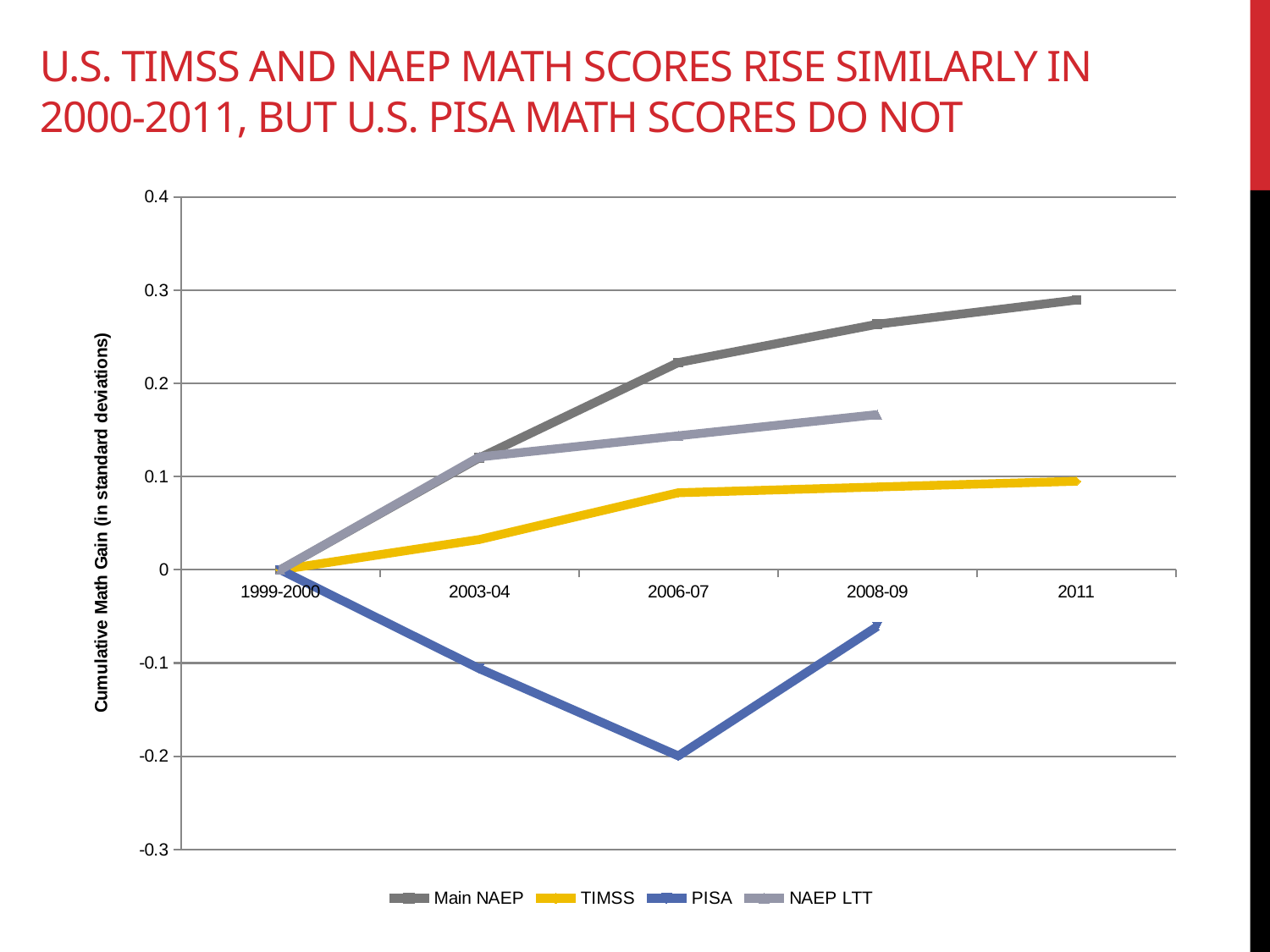
Which series has the highest value at 2008-09? Main NAEP What kind of chart is shown on the slide? Line chart Does the PISA line rise or fall from 1999-2000 to 2006-07? Fall Is the value for NAEP LTT at 2008-09 greater or less than 0.1? greater Which series has the lowest value at 2006-07? PISA At 2008-09, which is larger: Main NAEP or NAEP LTT? Main NAEP Is the value for TIMSS at 2011 greater or less than 0.1? less What is the title of the y axis? Cumulative Math Gain (in standard deviations) Is the value for Main NAEP at 2006-07 greater or less than 0.2? greater How many time periods are labelled on the x axis? 5 How many series does the legend list? 4